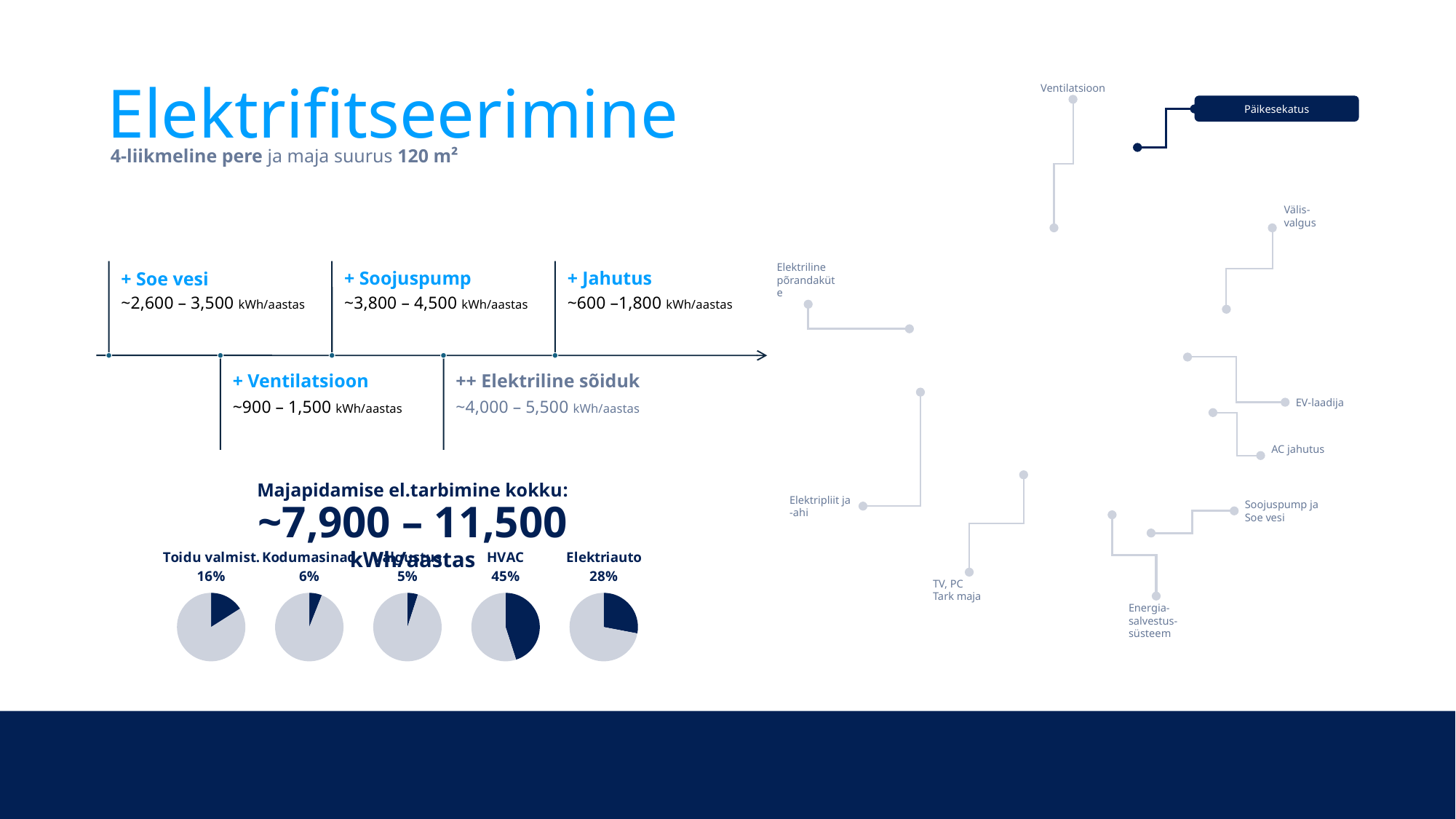
Among the pie charts at the bottom left, which category has the largest share? HVAC In the pie charts at the bottom left, what share is shown for HVAC? 45% In the pie charts at the bottom left, what share is shown in the third pie chart from the left? 5% In the pie charts at the bottom left, which share is larger: HVAC or Elektriauto? HVAC In the pie charts at the bottom left, what share is shown for Toidu valmist.? 16% How many small pie charts are shown at the bottom left of the slide? 5 Among the pie charts at the bottom left, which labelled category has the smallest share? The third pie chart (5%) In the pie charts at the bottom left, what is the difference between the HVAC share and the Elektriauto share? 17% In the pie charts at the bottom left, what is the difference between the Toidu valmist. share and the Kodumasinad share? 10% What kind of charts are the five small charts at the bottom left of the slide? Pie charts In the pie charts at the bottom left, what share is shown for Kodumasinad? 6% In the pie charts at the bottom left, what share is shown for Elektriauto? 28%